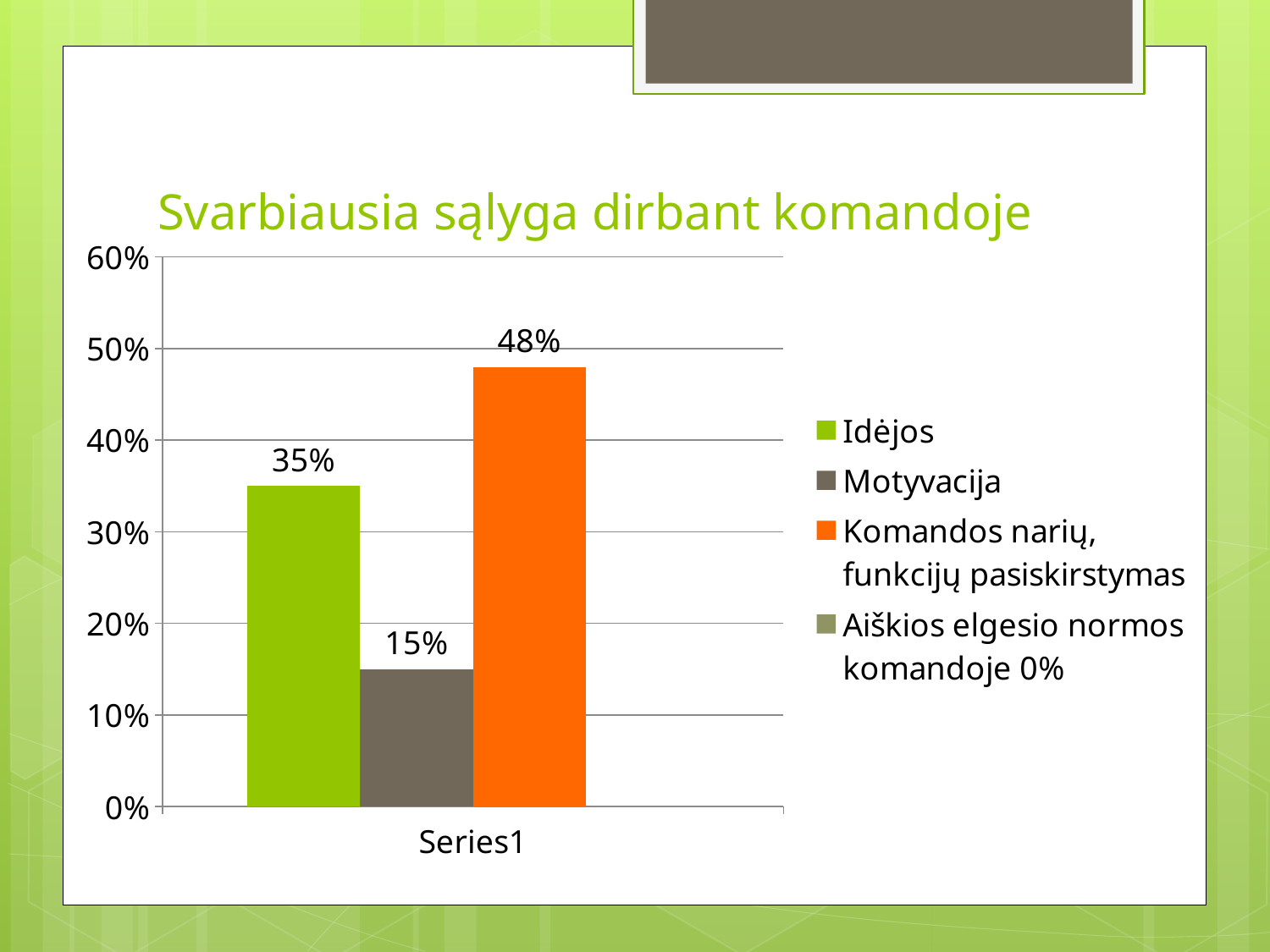
Which legend entry has the highest value? Komandos narių, funkcijų pasiskirstymas What is the difference between the values for Komandos narių, funkcijų pasiskirstymas and Idėjos? 13% Is the value for Komandos narių, funkcijų pasiskirstymas greater or less than 40%? greater What is the value for Idėjos? 35% What kind of chart is shown on the slide? Bar chart What is the value for Komandos narių, funkcijų pasiskirstymas? 48% What is the value for Motyvacija? 15% Which is larger, the value for Idėjos or the value for Motyvacija? Idėjos What is the title of the chart? Svarbiausia sąlyga dirbant komandoje What is the difference between the values for Idėjos and Motyvacija? 20% Which of the plotted bars has the lowest value? Motyvacija How many entries does the legend list? 4